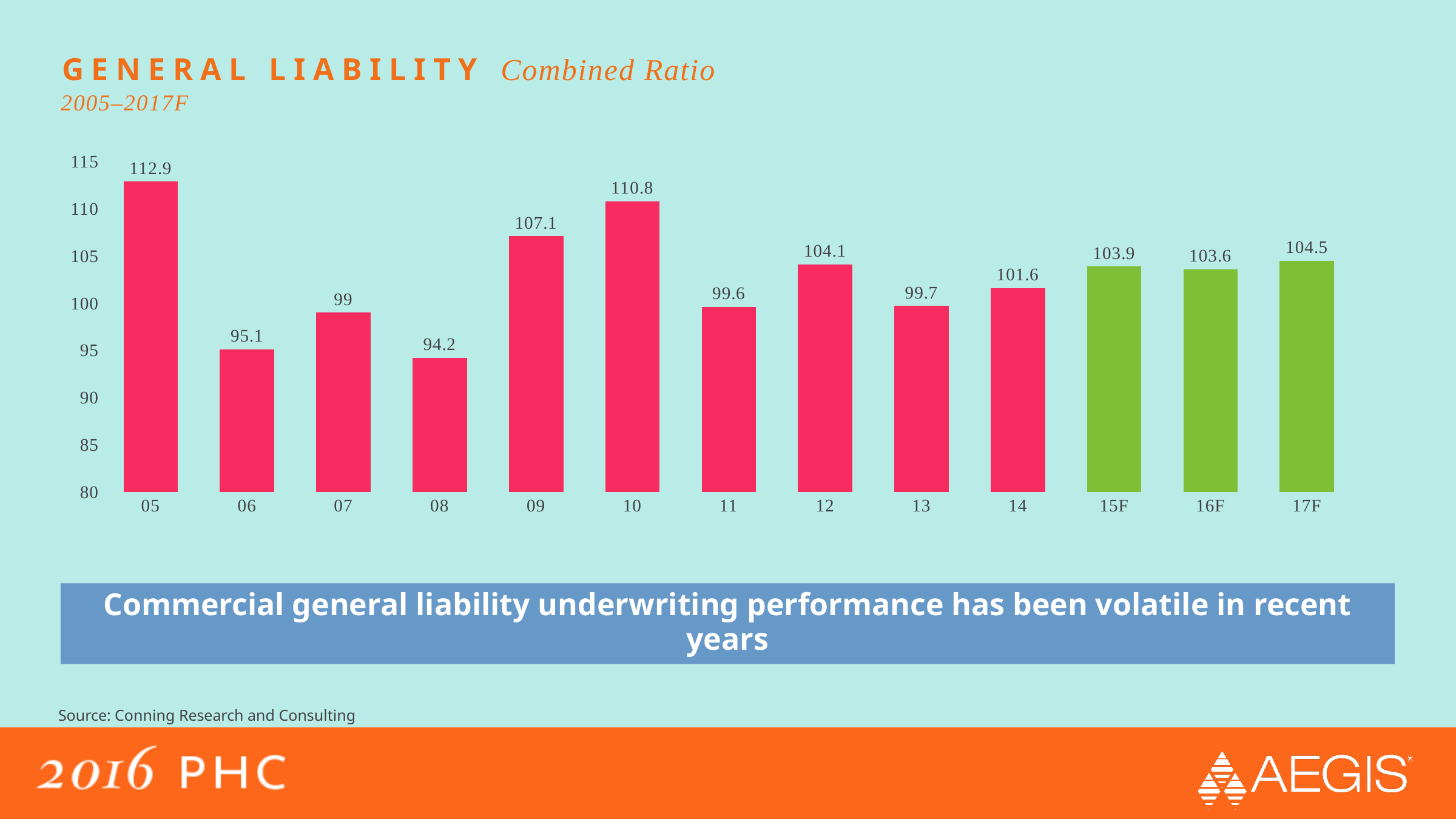
Which year has the highest combined ratio? 05 What is the combined ratio for 08? 94.2 What colour are the bars for the forecast years 15F, 16F and 17F? green How many years are shown on the x axis? 13 Which year has the lowest combined ratio? 08 Which is larger, the combined ratio for 09 or for 12? 09 What is the combined ratio for 16F? 103.6 Is the value for 14 greater or less than 100? greater Do the values rise or fall from 06 to 07? rise What is the difference between the combined ratio for 10 and for 11? 11.2 What kind of chart is shown on the slide? bar chart What is the combined ratio for 05? 112.9